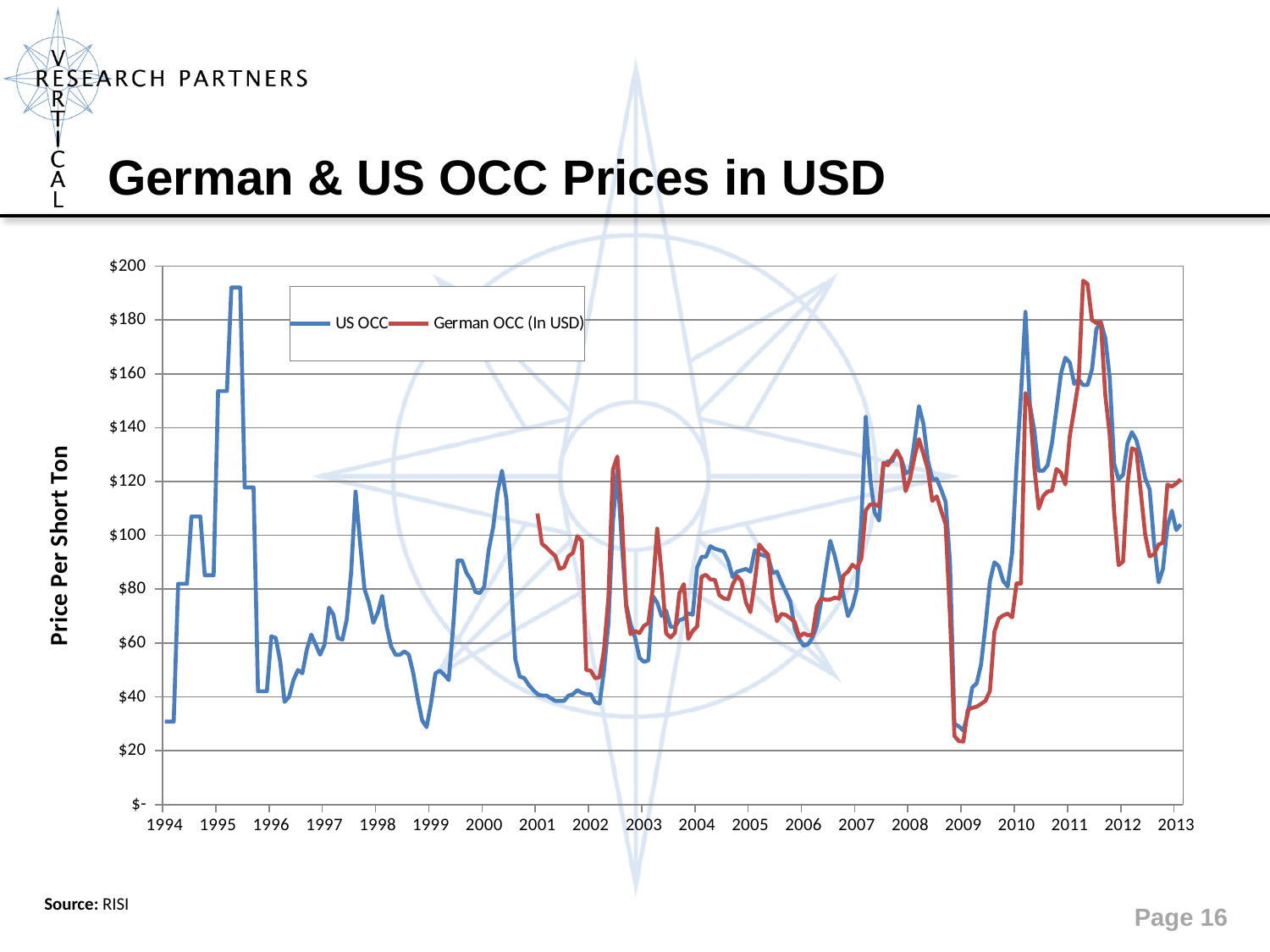
Is the lowest value of German OCC (In USD) in 2009 greater or less than $40? less Is the peak value of US OCC in 1995 greater or less than $180? greater What is the label on the vertical axis? Price Per Short Ton Is the value of US OCC at the start of 1994 greater or less than $40? less How many series does the legend list? 2 At the 2010 peak, which series is higher, US OCC or German OCC (In USD)? US OCC What are the two series named in the legend? US OCC and German OCC (In USD) Does the US OCC price rise or fall from its low in 2009 to its peak in 2010? rise What kind of chart is shown on the slide? line chart How many year labels are shown on the x axis? 20